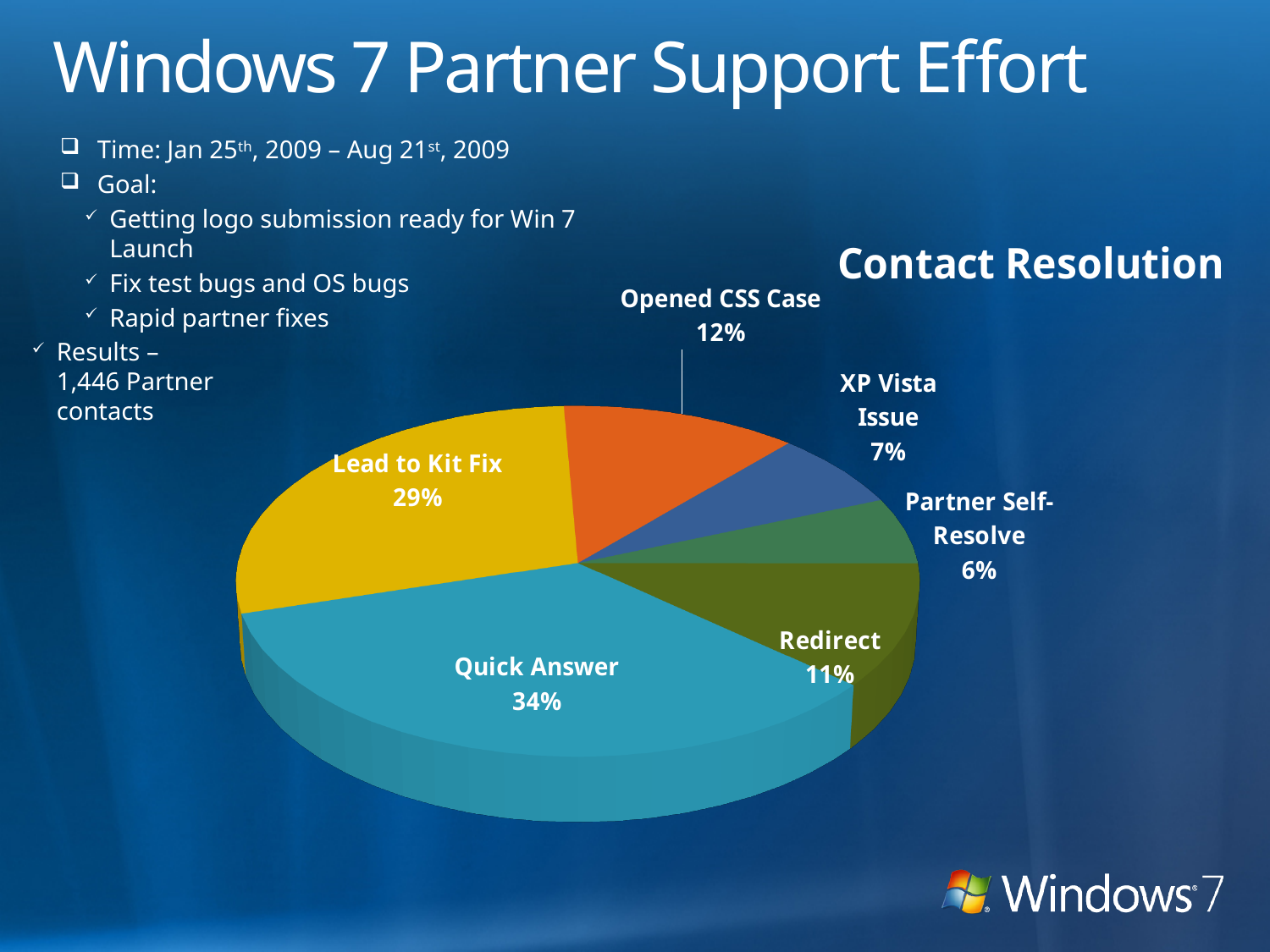
What percentage of contacts were resolved by Redirect? 11% What share of contact resolutions is Lead to Kit Fix? 29% How many percentage points larger is Quick Answer than Lead to Kit Fix? 5 Which contact resolution category has the largest share? Quick Answer What is the title of the chart? Contact Resolution Which is larger, Opened CSS Case or Redirect? Opened CSS Case What percentage of contacts were resolved by Opened CSS Case? 12% How many categories does the Contact Resolution pie chart show? 6 What share of contact resolutions is Quick Answer? 34% What percentage of contacts were XP Vista Issue? 7% Which contact resolution category has the smallest share? Partner Self-Resolve What kind of chart is shown on the slide? Pie chart